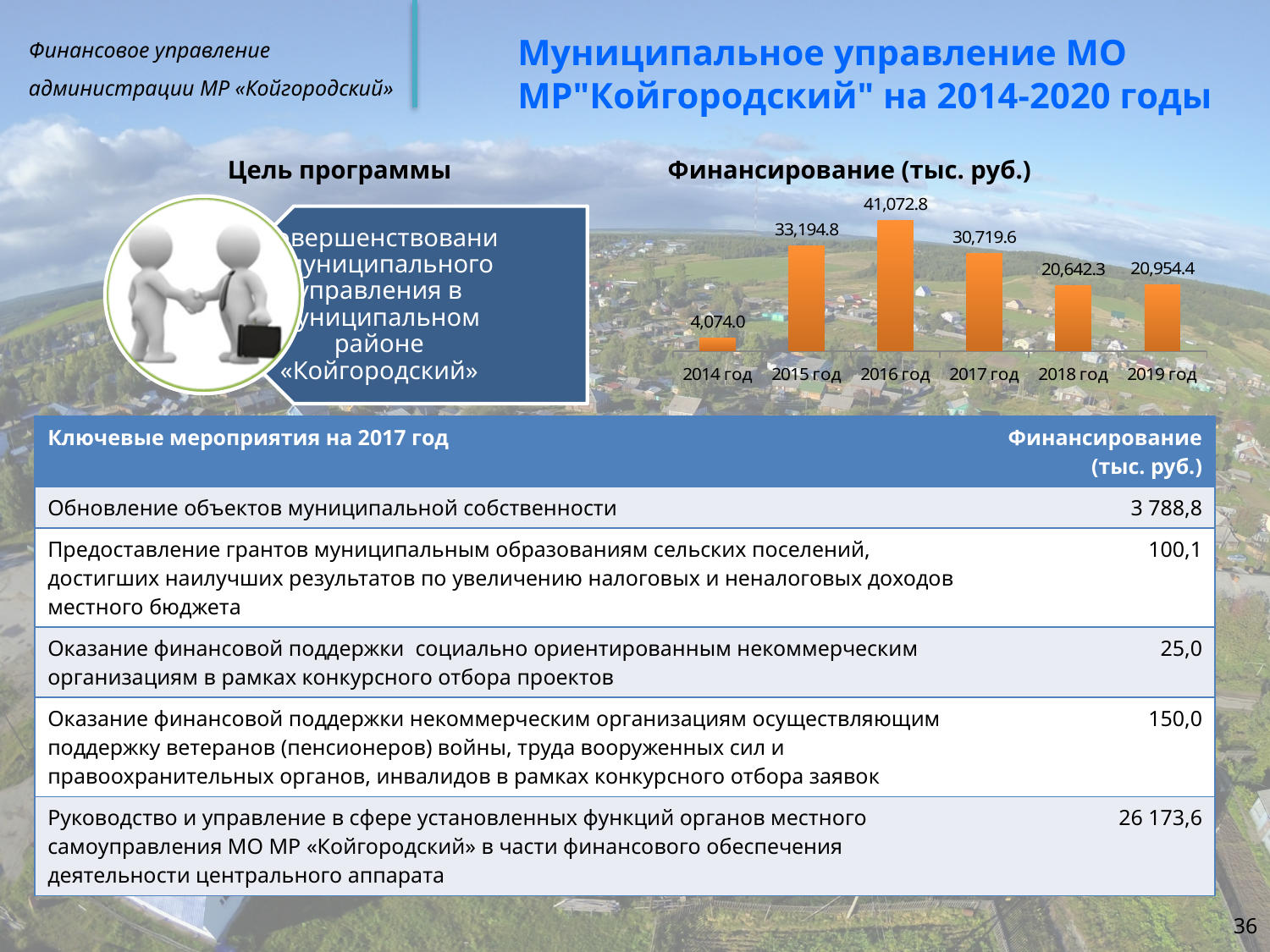
Which year has the lowest value in the Финансирование (тыс. руб.) chart? 2014 год What is the difference between the values for 2016 год and 2017 год in the Финансирование (тыс. руб.) chart? 10,353.2 What is the difference between the values for 2015 год and 2014 год in the Финансирование (тыс. руб.) chart? 29,120.8 What is the title of the chart on the slide? Финансирование (тыс. руб.) What is the value for 2014 год in the Финансирование (тыс. руб.) chart? 4,074.0 Which is larger in the Финансирование (тыс. руб.) chart: the value for 2015 год or the value for 2017 год? 2015 год How many years are shown in the Финансирование (тыс. руб.) chart? 6 What is the value for 2016 год in the Финансирование (тыс. руб.) chart? 41,072.8 What is the value for 2018 год in the Финансирование (тыс. руб.) chart? 20,642.3 What kind of chart is the Финансирование (тыс. руб.) chart? bar chart What is the value for 2017 год in the Финансирование (тыс. руб.) chart? 30,719.6 Which year has the highest value in the Финансирование (тыс. руб.) chart? 2016 год